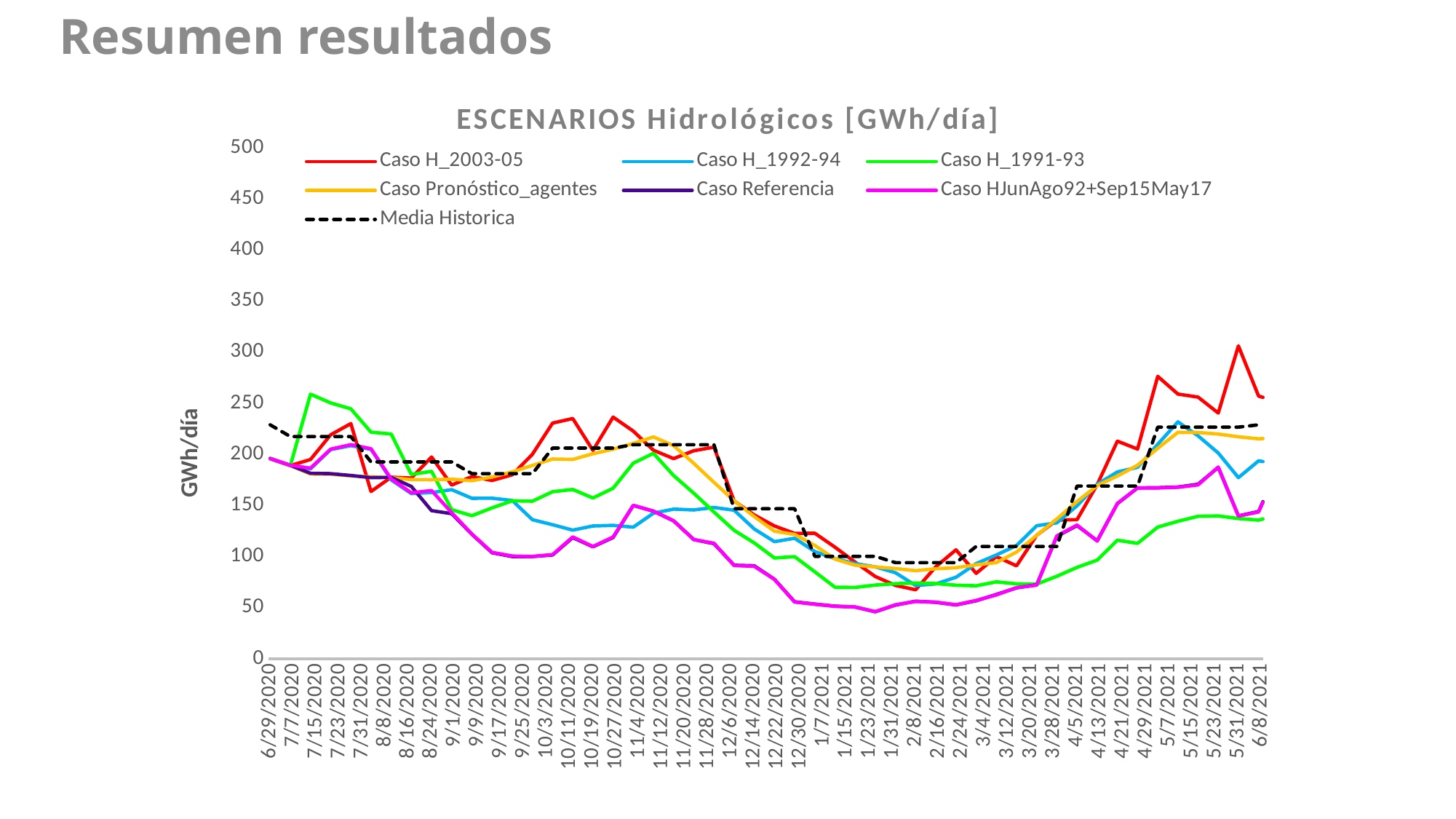
What kind of chart is shown on the slide? line chart Is the value for Media Historica at 6/29/2020 greater or less than 200? greater How many series does the legend of the chart list? 7 What is the title of the chart? ESCENARIOS Hidrológicos [GWh/día] Is the value for Caso HJunAgo92+Sep15May17 at 1/23/2021 greater or less than 100? less At 1/23/2021, which series has the larger value: Caso H_1991-93 or Caso HJunAgo92+Sep15May17? Caso H_1991-93 Is the value for Caso H_1991-93 at 7/15/2020 greater or less than 200? greater At 6/8/2021, which series has the larger value: Caso H_2003-05 or Caso H_1991-93? Caso H_2003-05 Which series in the chart is drawn with a dashed line? Media Historica Which series reaches the highest value anywhere on the chart? Caso H_2003-05